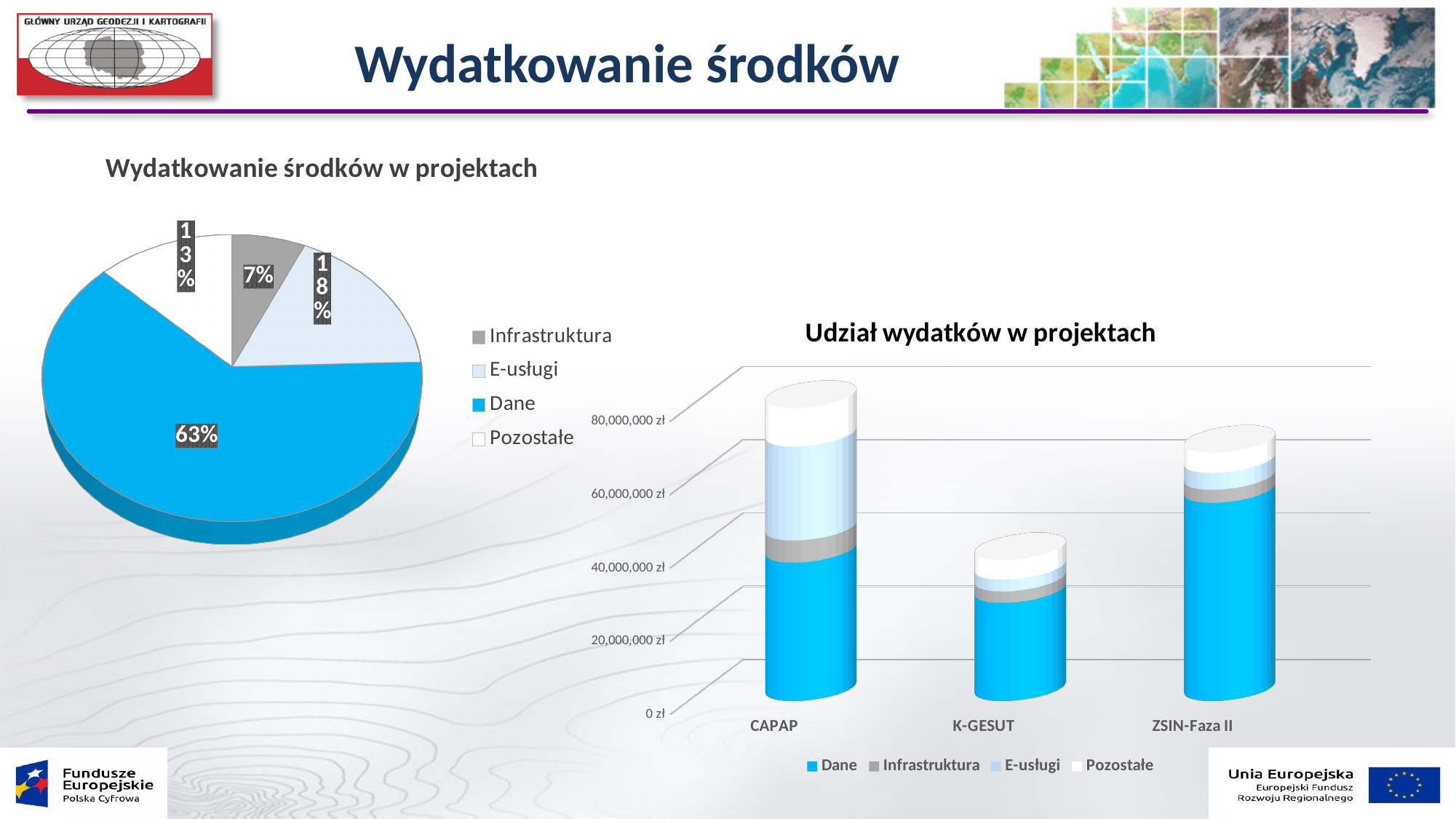
In the chart titled 'Udział wydatków w projektach', is the total for ZSIN-Faza II greater or less than 60,000,000 zł? greater In the pie chart titled 'Wydatkowanie środków w projektach', what share does Infrastruktura have? 7% In the pie chart titled 'Wydatkowanie środków w projektach', which category has the largest slice? Dane In the pie chart titled 'Wydatkowanie środków w projektach', which is larger, Pozostałe or Infrastruktura? Pozostałe In the pie chart titled 'Wydatkowanie środków w projektach', what share does Dane have? 63% In the chart titled 'Udział wydatków w projektach', how many projects are shown on the x axis? 3 In the pie chart titled 'Wydatkowanie środków w projektach', what share does E-usługi have? 18% In the pie chart titled 'Wydatkowanie środków w projektach', how many percentage points larger is Dane than E-usługi? 45 In the chart titled 'Udział wydatków w projektach', how many series does the legend list? 4 In the chart titled 'Udział wydatków w projektach', which project has the shortest bar? K-GESUT In the chart titled 'Udział wydatków w projektach', which project has the tallest bar? CAPAP In the pie chart titled 'Wydatkowanie środków w projektach', which category has the smallest slice? Infrastruktura